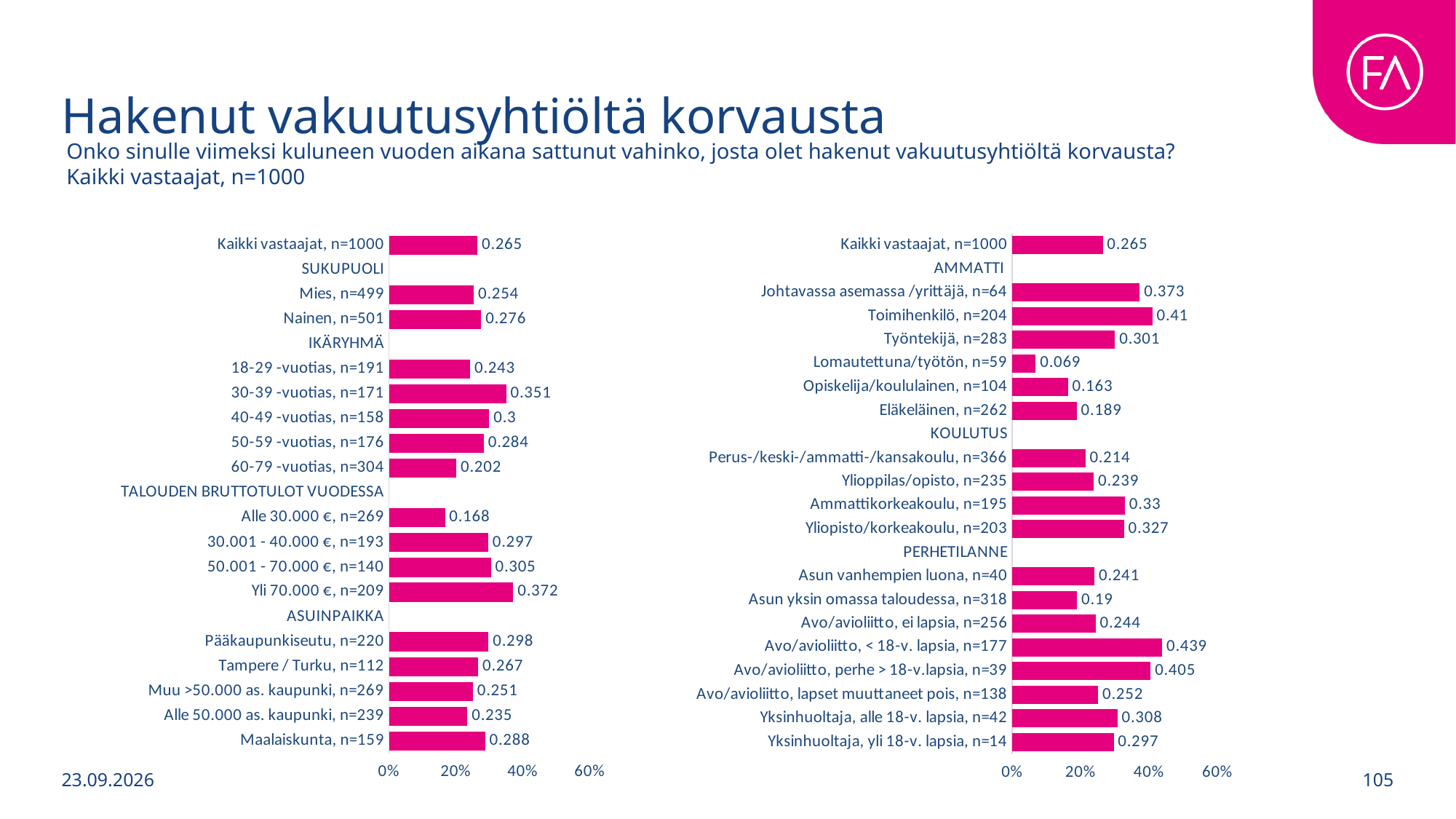
In the right chart, what is the value for Toimihenkilö, n=204? 0.41 In the right chart, what is the value for Eläkeläinen, n=262? 0.189 In the right chart, which category has the lowest value? Lomautettuna/työtön, n=59 In the right chart, which category has the highest value? Avo/avioliitto, < 18-v. lapsia, n=177 In the left chart, what is the value for Nainen, n=501? 0.276 What kind of chart is shown on the left of the slide? bar chart In the right chart, what is the difference between the values for Toimihenkilö, n=204 and Työntekijä, n=283? 0.109 In the left chart, which category has the lowest value? Alle 30.000 €, n=269 In the right chart, is the value for Avo/avioliitto, perhe > 18-v.lapsia, n=39 greater or less than 20%? greater In the left chart, which category has the highest value? Yli 70.000 €, n=209 In the left chart, what is the difference between the values for Nainen, n=501 and Mies, n=499? 0.022 In the left chart, which is larger: the value for 30-39 -vuotias, n=171 or 60-79 -vuotias, n=304? 30-39 -vuotias, n=171